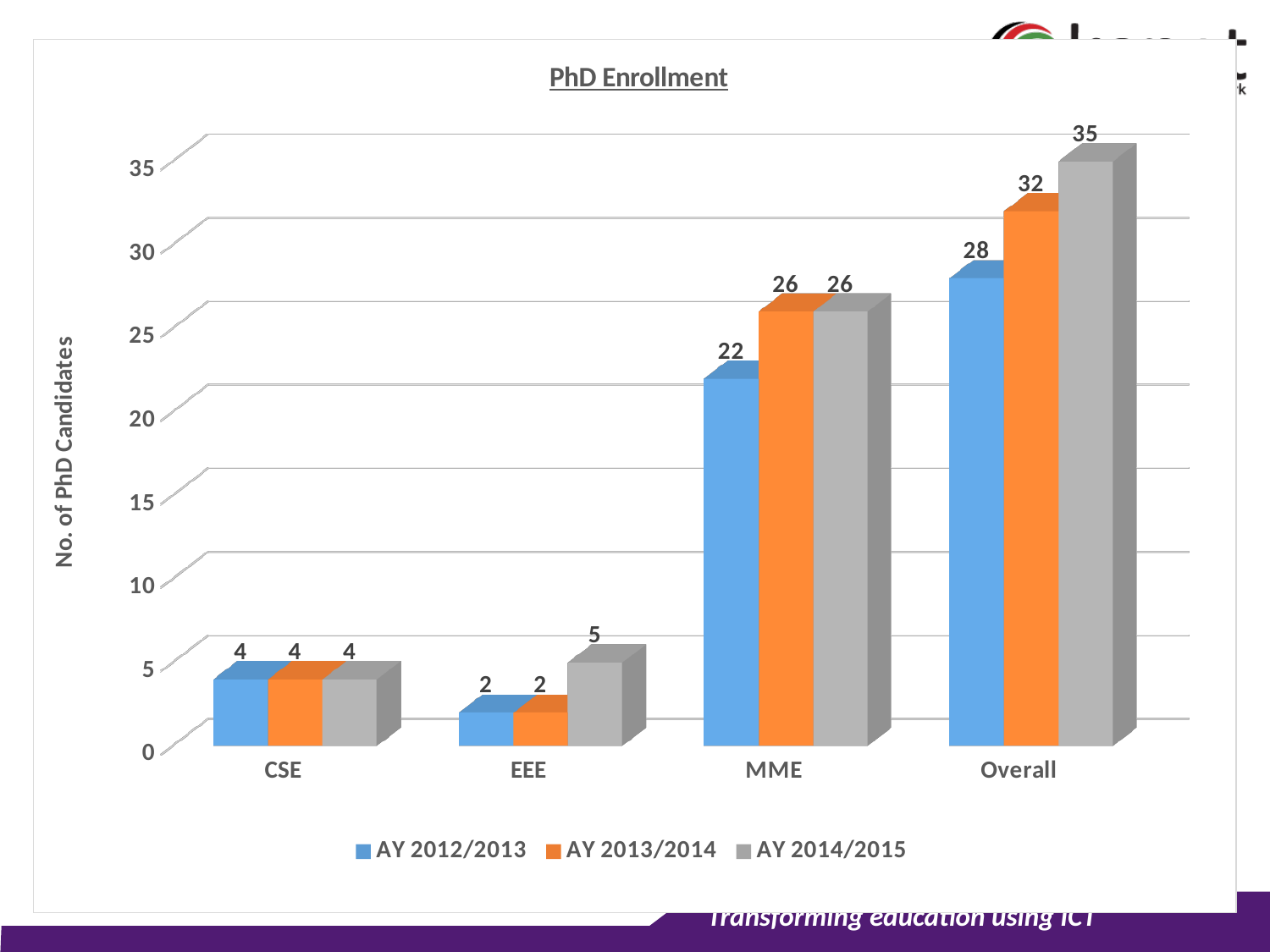
Which category has the highest PhD enrollment in AY 2014/2015? Overall What is the title of the chart? PhD Enrollment How many series does the legend list? 3 How many categories are shown on the x axis? 4 Which category has the lowest PhD enrollment in AY 2012/2013? EEE What is the PhD enrollment for EEE in AY 2014/2015? 5 What is the PhD enrollment for MME in AY 2012/2013? 22 What is the Overall PhD enrollment in AY 2013/2014? 32 What is the difference between the Overall PhD enrollment in AY 2014/2015 and AY 2012/2013? 7 What kind of chart is shown on the slide? Bar chart Is the PhD enrollment for MME in AY 2013/2014 larger than for CSE in AY 2013/2014? Yes Is the Overall PhD enrollment in AY 2012/2013 greater or less than 25? greater